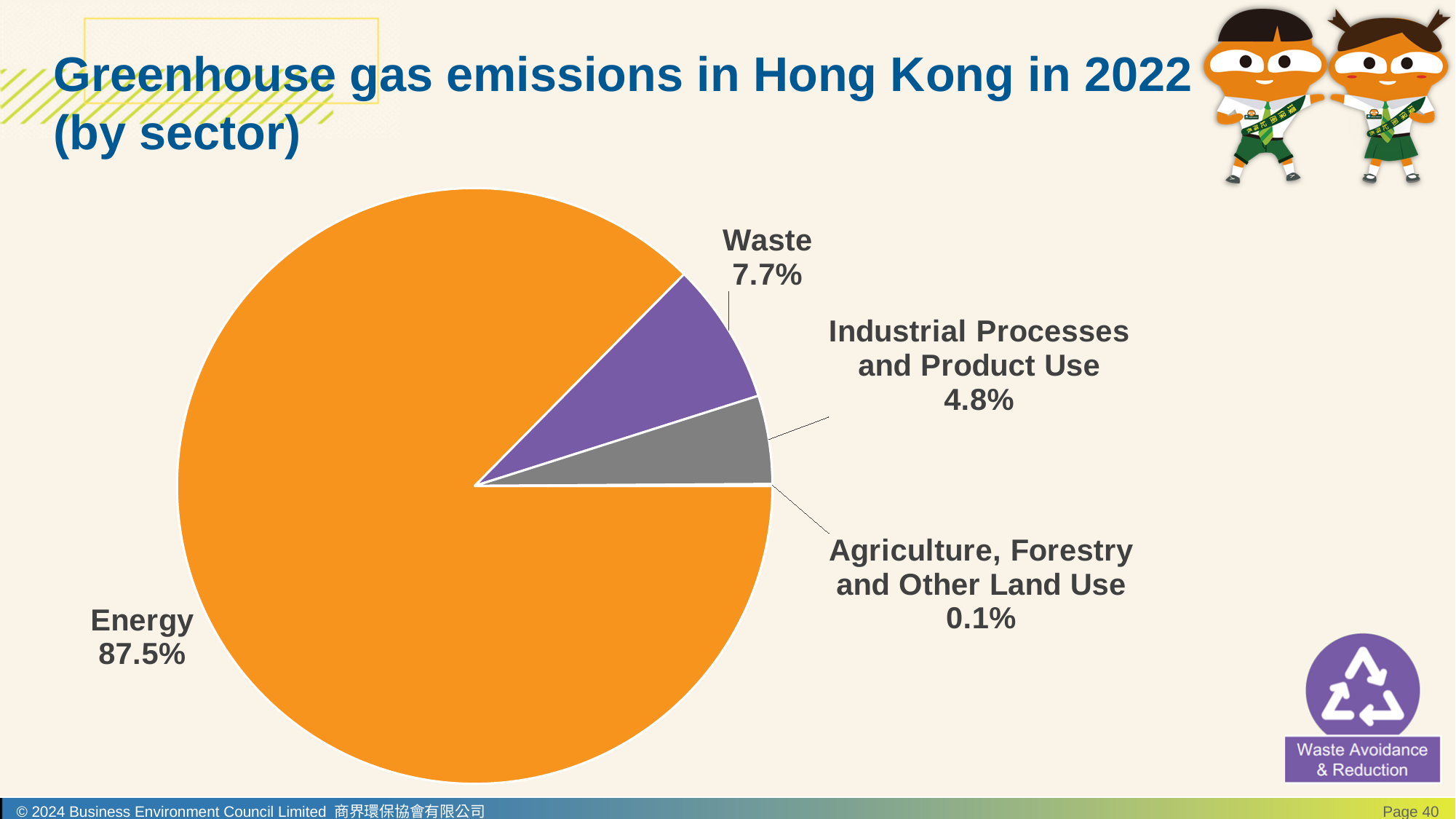
What share of greenhouse gas emissions comes from Agriculture, Forestry and Other Land Use? 0.1% What share of greenhouse gas emissions comes from Industrial Processes and Product Use? 4.8% How many sectors are shown in the pie chart? 4 What is the title of the chart? Greenhouse gas emissions in Hong Kong in 2022 (by sector) Which sector has the smallest share of emissions? Agriculture, Forestry and Other Land Use What share of greenhouse gas emissions comes from the Energy sector? 87.5% Which has a larger share, Waste or Industrial Processes and Product Use? Waste What is the difference in percentage points between the Energy share and the Waste share? 79.8 What is the difference in percentage points between the Waste share and the Industrial Processes and Product Use share? 2.9 What kind of chart is shown on the slide? pie chart What share of greenhouse gas emissions comes from Waste? 7.7% Which sector has the largest share of emissions? Energy